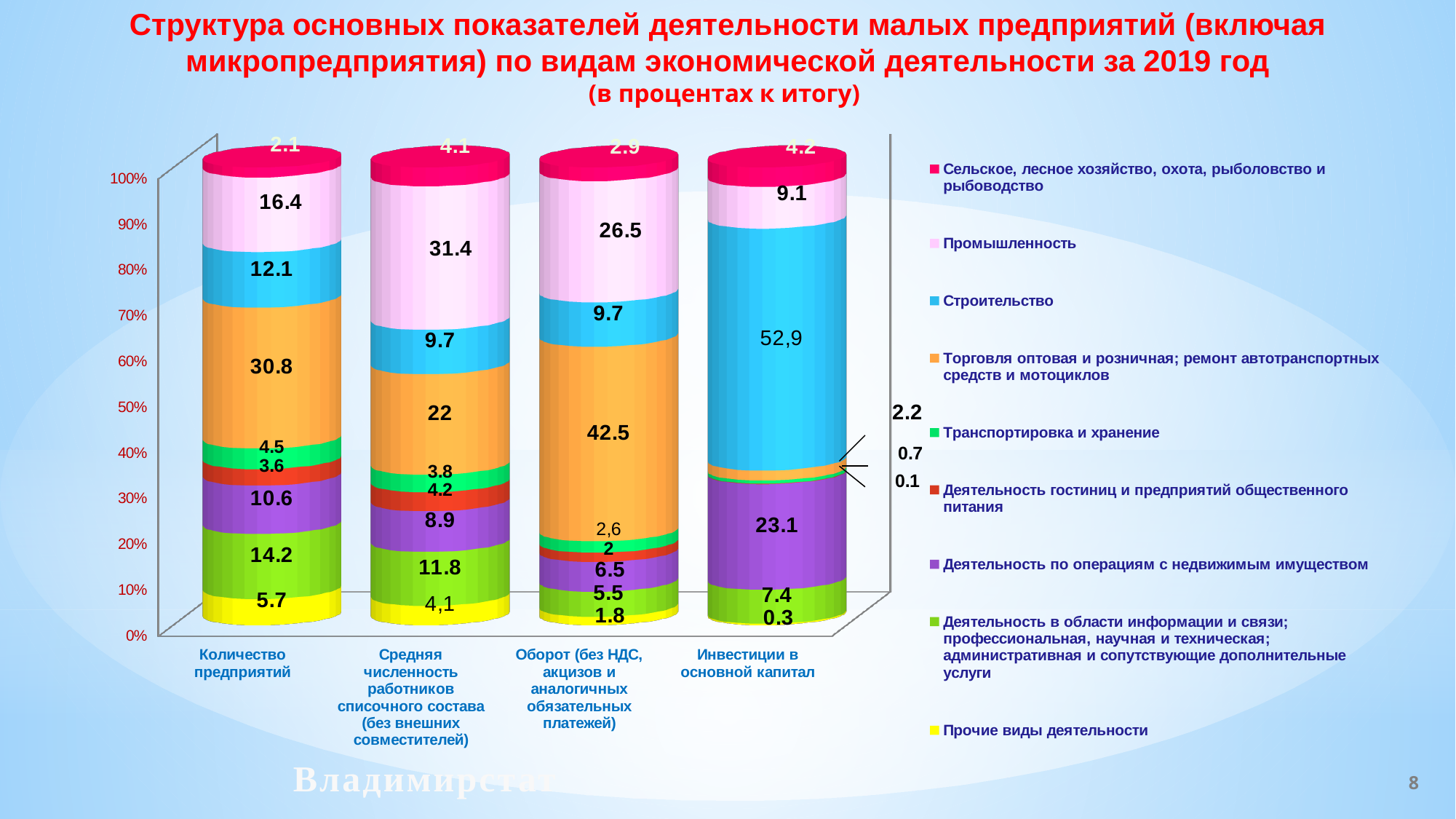
Which category has the highest value for Строительство? Инвестиции в основной капитал How many categories are shown along the x axis? 4 What is the value for Торговля оптовая и розничная in the Оборот (без НДС, акцизов и аналогичных обязательных платежей) bar? 42.5 What is the value for Строительство in the Инвестиции в основной капитал bar? 52,9 Which colour represents Прочие виды деятельности in the legend? Yellow How many series does the legend list? 9 What is the value for Деятельность по операциям с недвижимым имуществом in the Количество предприятий bar? 10.6 Which category has the lowest value for Прочие виды деятельности? Инвестиции в основной капитал What is the difference between the Торговля оптовая и розничная values for Количество предприятий and Средняя численность работников списочного состава? 8.8 Which is larger: the Промышленность value for Количество предприятий or for Оборот (без НДС, акцизов и аналогичных обязательных платежей)? Оборот (без НДС, акцизов и аналогичных обязательных платежей) What is the value for Промышленность in the Средняя численность работников списочного состава bar? 31.4 What kind of chart is shown on the slide? Stacked bar chart